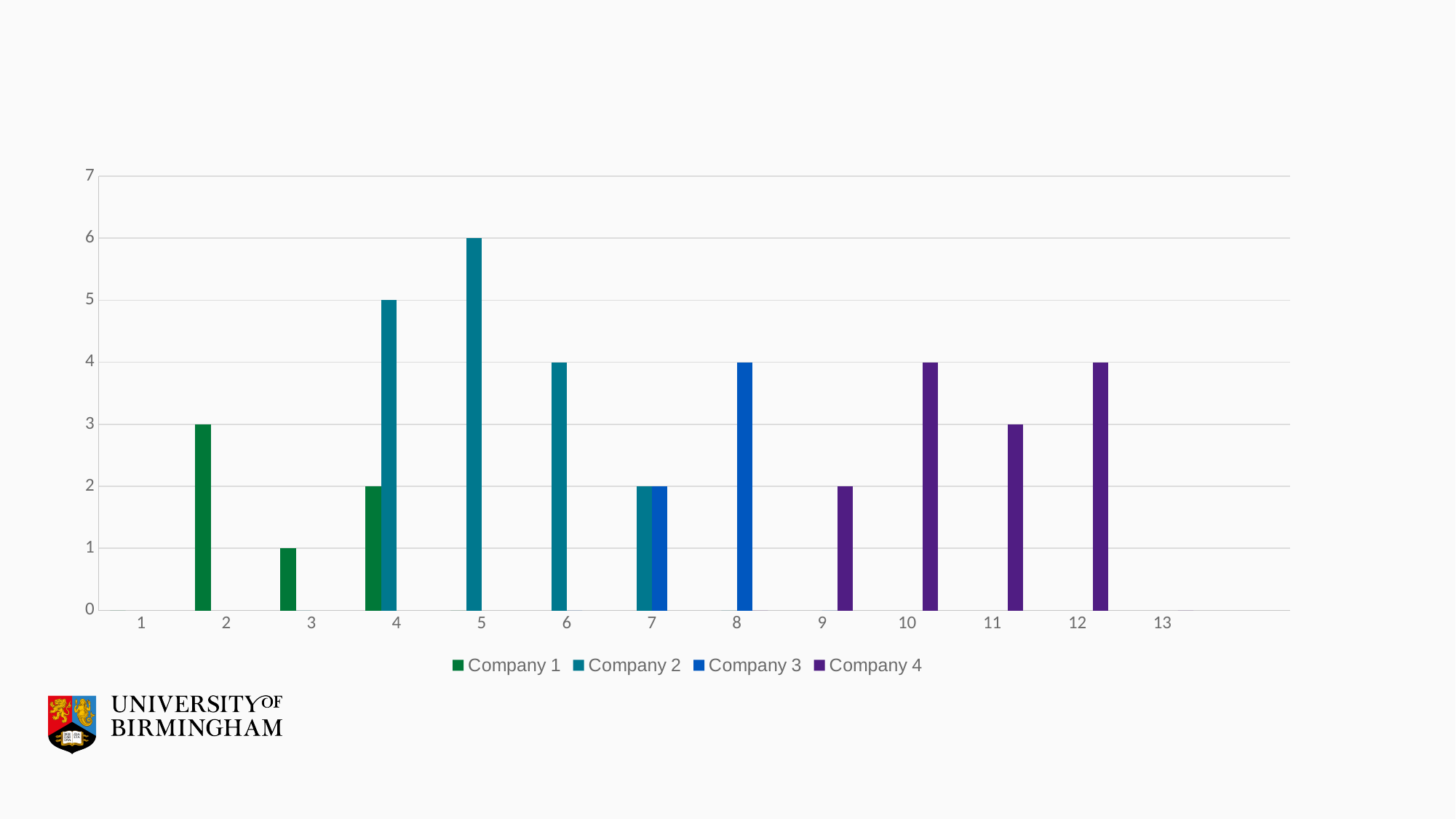
What is the value of the Company 2 bar at category 5? 6 What is the value of the Company 4 bar at category 11? 3 How many categories are labelled along the x axis? 13 What is the difference between the Company 2 bar at category 5 and the Company 1 bar at category 3? 5 Is the value of the Company 2 bar at category 5 greater or less than 4? greater How many series does the legend list? 4 Which series has the tallest bar on the chart? Company 2 What kind of chart is shown on the slide? Bar chart What is the value of the Company 2 bar at category 4? 5 Which is larger: the Company 2 bar at category 5 or the Company 2 bar at category 6? Category 5 At which category does Company 1 have its lowest bar? 3 What is the value of the Company 1 bar at category 2? 3